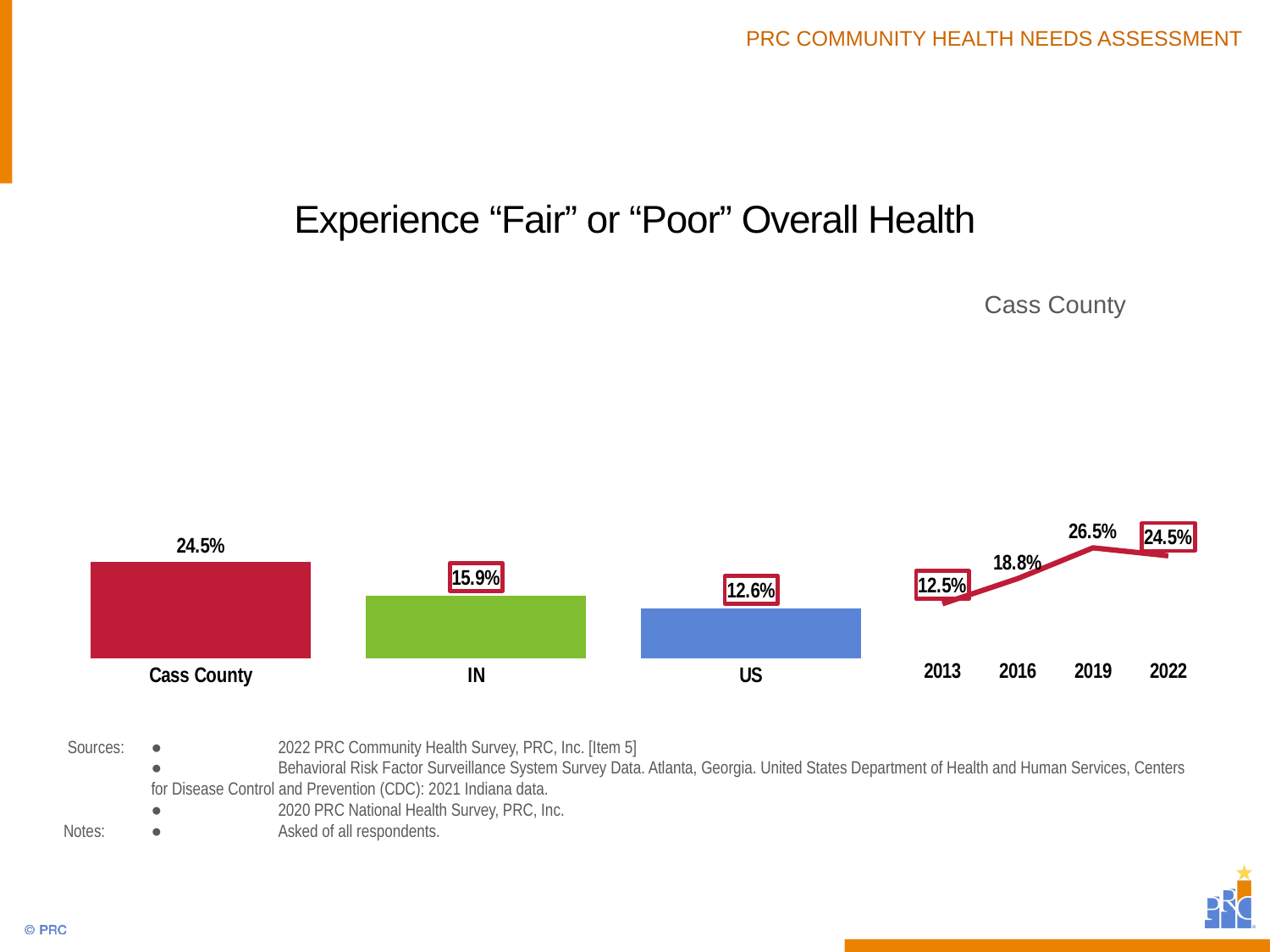
In the bar chart on the left, which category has the lowest value? US In the line chart on the right, what is the difference between the 2016 value and the 2013 value? 6.3% What kind of chart is the chart on the left? Bar chart In the line chart on the right, what is the value for 2019? 26.5% In the line chart on the right, what is the value for 2013? 12.5% In the bar chart on the left, what is the value for Cass County? 24.5% In the bar chart on the left, what is the value for IN? 15.9% In the line chart on the right, which year has the highest value? 2019 In the bar chart on the left, what is the value for US? 12.6% In the bar chart on the left, which category has the highest value? Cass County In the bar chart on the left, what is the difference between the Cass County value and the US value? 11.9% In the bar chart on the left, how many categories are shown? 3